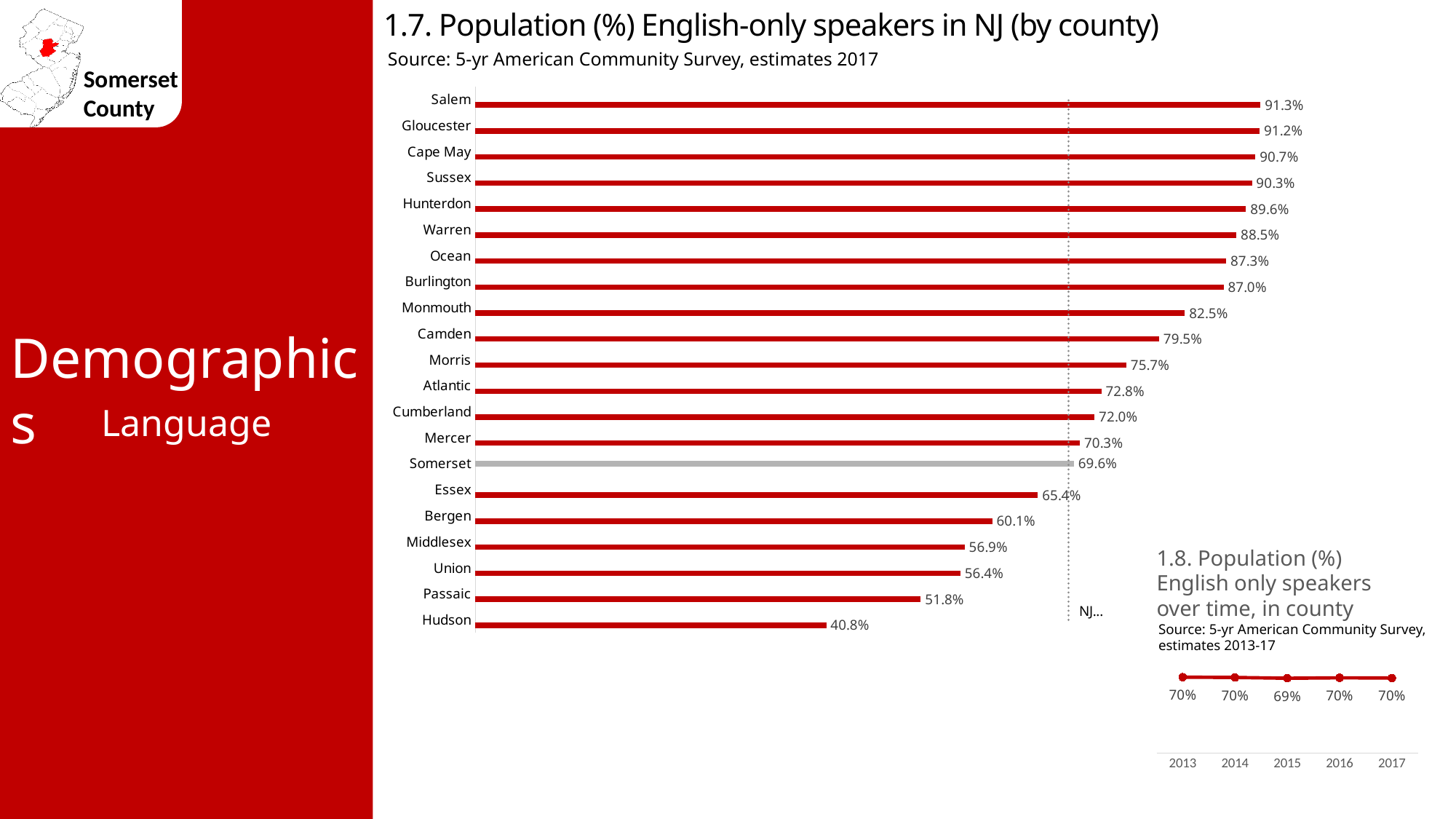
In chart 1.8 (Population (%) English only speakers over time, in county), how many years are plotted? 5 In chart 1.7 (Population (%) English-only speakers in NJ by county), what is the value for Somerset? 69.6% In chart 1.7 (Population (%) English-only speakers in NJ by county), which bar is shown in grey rather than red? Somerset In chart 1.7 (Population (%) English-only speakers in NJ by county), what is the value for Hudson? 40.8% In chart 1.7 (Population (%) English-only speakers in NJ by county), which has a larger value, Bergen or Essex? Essex In chart 1.7 (Population (%) English-only speakers in NJ by county), what is the difference between the values for Salem and Hudson? 50.5% In chart 1.8 (Population (%) English only speakers over time, in county), what is the value for 2015? 69% In chart 1.7 (Population (%) English-only speakers in NJ by county), which county has the lowest value? Hudson In chart 1.7 (Population (%) English-only speakers in NJ by county), how many counties are plotted? 21 In chart 1.7 (Population (%) English-only speakers in NJ by county), which county has the highest value? Salem What kind of chart is chart 1.7 (Population (%) English-only speakers in NJ by county)? Bar chart In chart 1.7 (Population (%) English-only speakers in NJ by county), what is the value for Middlesex? 56.9%